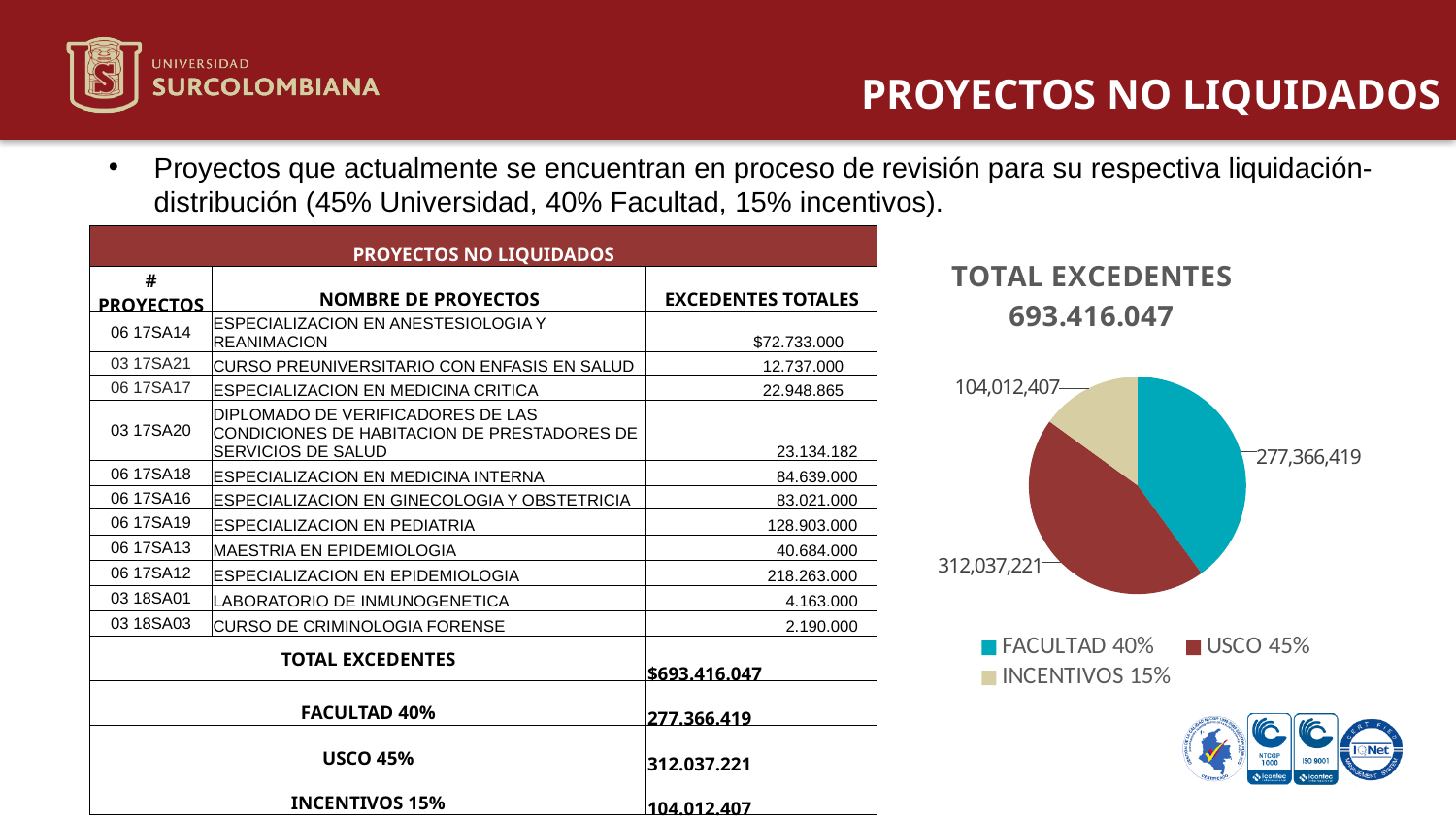
What kind of chart is shown on the slide? pie chart How many slices does the pie chart have? 3 What is the value for USCO 45% in the pie chart? 312,037,221 What is the value for INCENTIVOS 15% in the pie chart? 104,012,407 Which is larger in the pie chart, the value for FACULTAD 40% or the value for INCENTIVOS 15%? FACULTAD 40% Which slice of the pie chart has the smallest value? INCENTIVOS 15% What share of the pie does the INCENTIVOS slice represent? 15% What is the difference between the FACULTAD 40% value and the INCENTIVOS 15% value in the pie chart? 173,354,012 What is the value for FACULTAD 40% in the pie chart? 277,366,419 What is the title of the pie chart? TOTAL EXCEDENTES 693.416.047 Which slice of the pie chart has the largest value? USCO 45% What is the difference between the USCO 45% value and the FACULTAD 40% value in the pie chart? 34,670,802